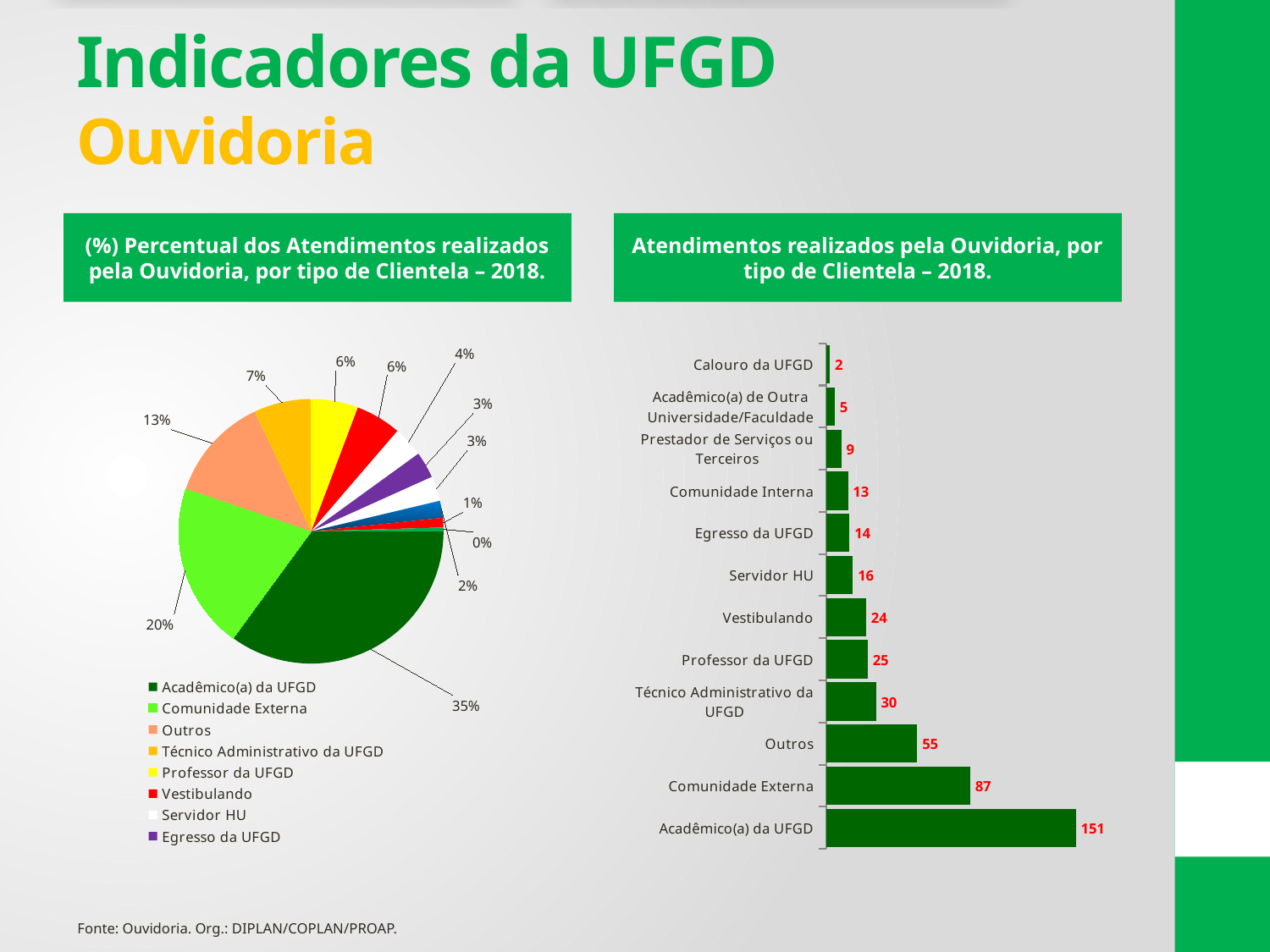
In the bar chart on the right, which is larger: Vestibulando or Professor da UFGD? Professor da UFGD In the bar chart on the right, what is the value for Comunidade Externa? 87 In the bar chart on the right, which category has the lowest value? Calouro da UFGD In the bar chart on the right, what is the difference between Comunidade Externa and Outros? 32 In the pie chart on the left, what share is shown for Acadêmico(a) da UFGD? 35% In the bar chart on the right, what is the value for Servidor HU? 16 In the bar chart on the right, how many atendimentos were recorded for Acadêmico(a) da UFGD? 151 What type of chart is the chart on the left of the slide? Pie chart How many categories are shown in the bar chart on the right? 12 How many entries does the legend of the pie chart on the left list? 8 In the bar chart on the right, which category has the highest value? Acadêmico(a) da UFGD In the pie chart on the left, what share is shown for Comunidade Externa? 20%